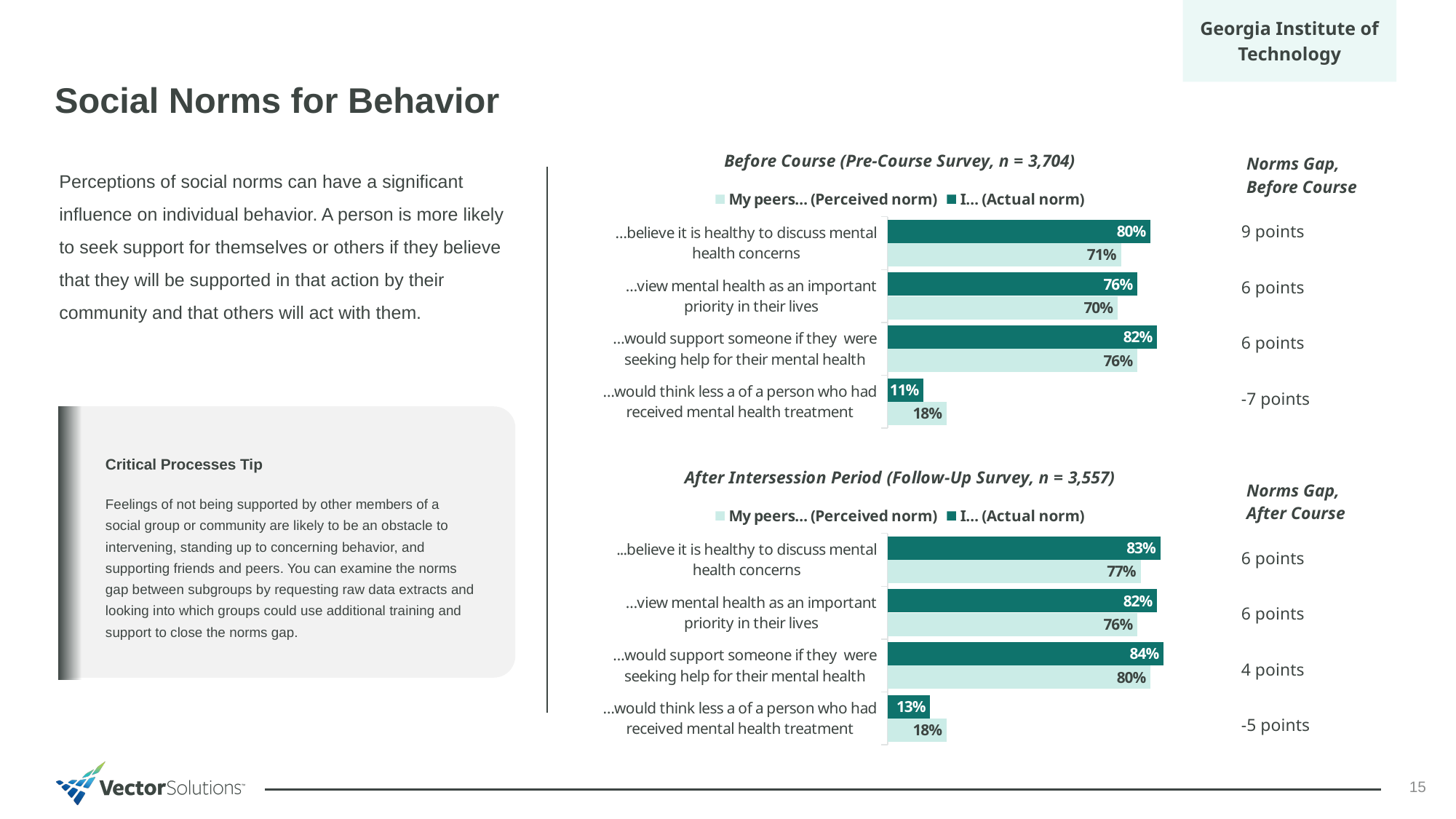
What is the sample size (n) stated in the title of the After Intersession Period chart? 3,557 In the Before Course chart, what is the value for 'I... (Actual norm)' for '...believe it is healthy to discuss mental health concerns'? 80% In the After Intersession Period chart, what is the value for 'My peers... (Perceived norm)' for '...view mental health as an important priority in their lives'? 76% In the Before Course chart, which category has the lowest 'I... (Actual norm)' value? ...would think less a of a person who had received mental health treatment In the Before Course chart, what is the difference between the 'I... (Actual norm)' and 'My peers... (Perceived norm)' values for '...believe it is healthy to discuss mental health concerns'? 9 points In the After Intersession Period chart, which category has the highest 'I... (Actual norm)' value? ...would support someone if they were seeking help for their mental health What kind of chart is the Before Course chart? Bar chart How many categories does the Before Course chart show? 4 In the After Intersession Period chart, what is the difference between the 'I... (Actual norm)' and 'My peers... (Perceived norm)' values for '...would support someone if they were seeking help for their mental health'? 4 points In the After Intersession Period chart, which is larger for '...would think less a of a person who had received mental health treatment': the 'I... (Actual norm)' value or the 'My peers... (Perceived norm)' value? My peers... (Perceived norm) In the Before Course chart, what is the value for 'My peers... (Perceived norm)' for '...would think less a of a person who had received mental health treatment'? 18% How many series does the legend of the After Intersession Period chart list? 2